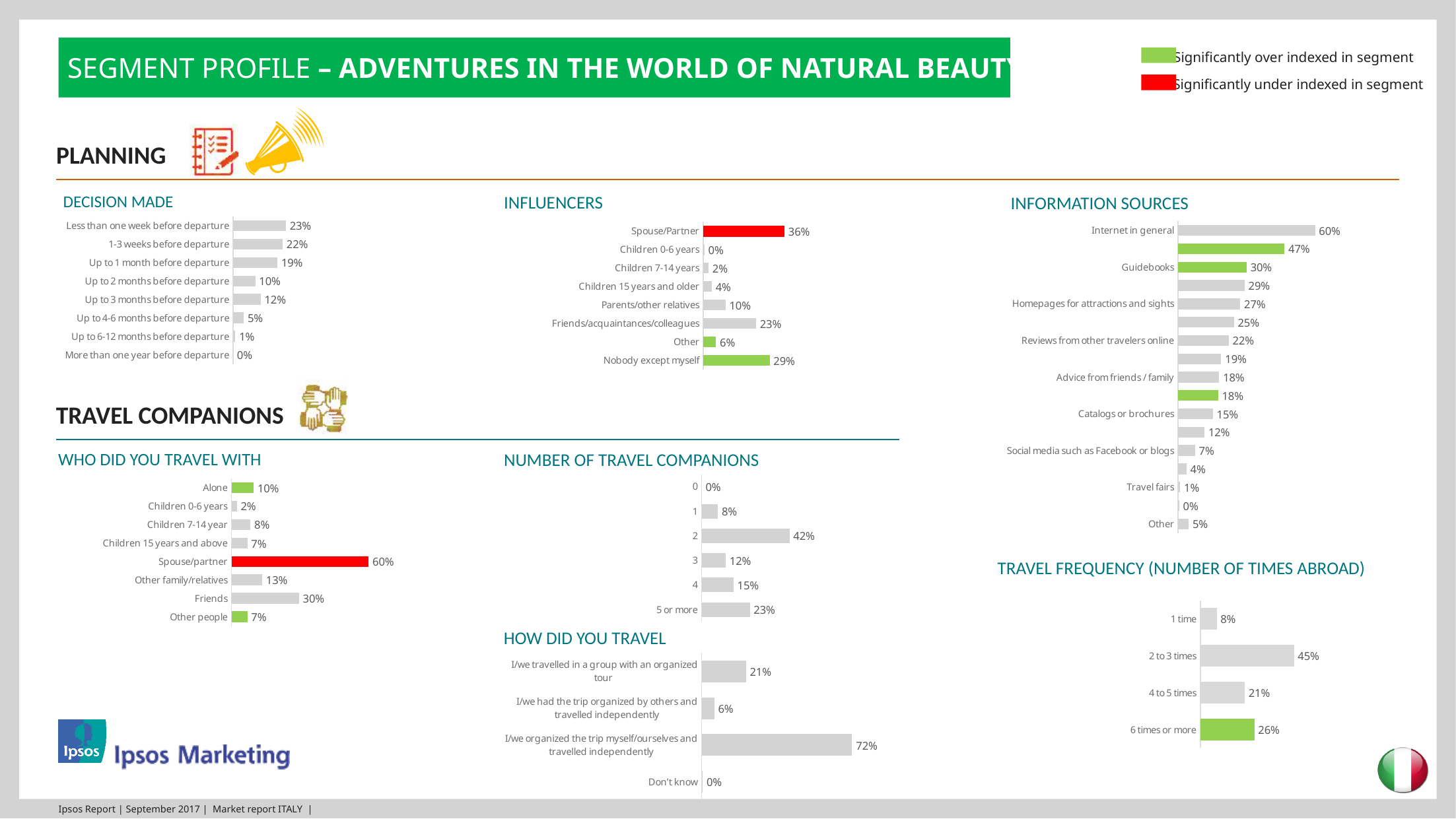
In the INFORMATION SOURCES chart, which is larger, Homepages for attractions and sights or Reviews from other travelers online? Homepages for attractions and sights In the TRAVEL FREQUENCY chart, which category has the lowest value? 1 time In the INFLUENCERS chart, what is the value for Spouse/Partner? 36% In the WHO DID YOU TRAVEL WITH chart, what is the value for Friends? 30% In the HOW DID YOU TRAVEL chart, what is the value for 'I/we organized the trip myself/ourselves and travelled independently'? 72% In the INFORMATION SOURCES chart, what is the value for Guidebooks? 30% In the DECISION MADE chart, which category has the highest value? Less than one week before departure In the WHO DID YOU TRAVEL WITH chart, which category has the highest value? Spouse/partner How many categories are shown in the TRAVEL FREQUENCY (NUMBER OF TIMES ABROAD) chart? 4 In the NUMBER OF TRAVEL COMPANIONS chart, what is the value for 2 companions? 42% In the INFLUENCERS chart, what is the difference between Spouse/Partner and Nobody except myself? 7% In the DECISION MADE chart, what percentage decided less than one week before departure? 23%